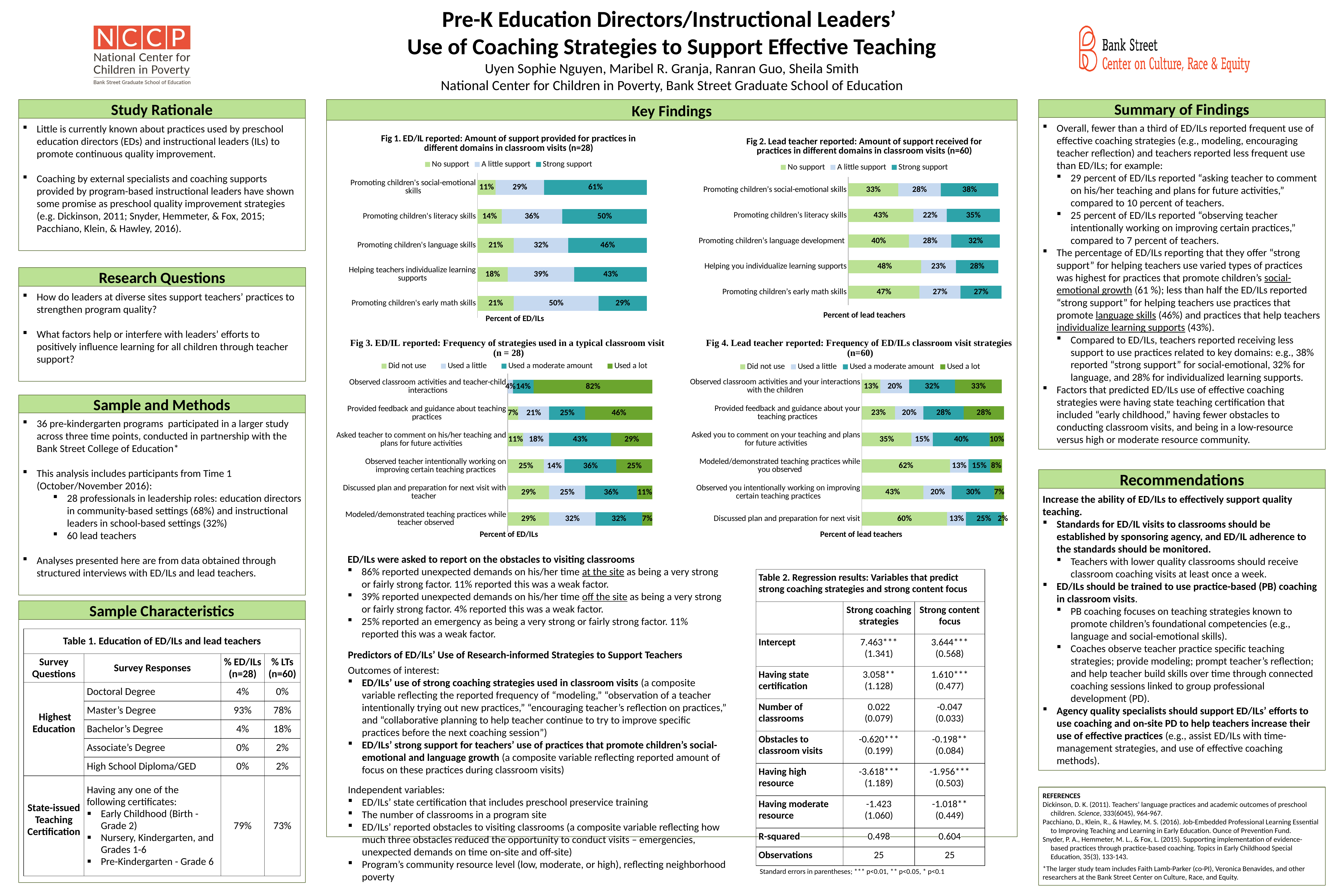
In Fig 4, which strategy has the lowest 'Used a lot' percentage? Discussed plan and preparation for next visit In Fig 3, how many strategies (categories) are plotted? 6 In Fig 1, what percentage of ED/ILs reported strong support for promoting children's social-emotional skills? 61% In Fig 1, which domain has the highest 'Strong support' percentage? Promoting children's social-emotional skills In Fig 4, what percentage of lead teachers reported 'Did not use' for modeled/demonstrated teaching practices while you observed? 62% In Fig 3, what percentage of ED/ILs reported 'Used a lot' for observed classroom activities and teacher-child interactions? 82% In Fig 2, what percentage of lead teachers reported no support for helping you individualize learning supports? 48% In Fig 1, what is the difference between the 'A little support' percentages for promoting children's early math skills and promoting children's social-emotional skills? 21% What type of chart is Fig 4? Stacked bar chart In Fig 2, how many series does the legend list? 3 In Fig 3, is the 'Used a moderate amount' value for 'Asked teacher to comment on his/her teaching and plans for future activities' larger or smaller than the 'Used a lot' value for the same strategy? larger In Fig 2, which domain has the lowest 'Strong support' percentage? Promoting children's early math skills